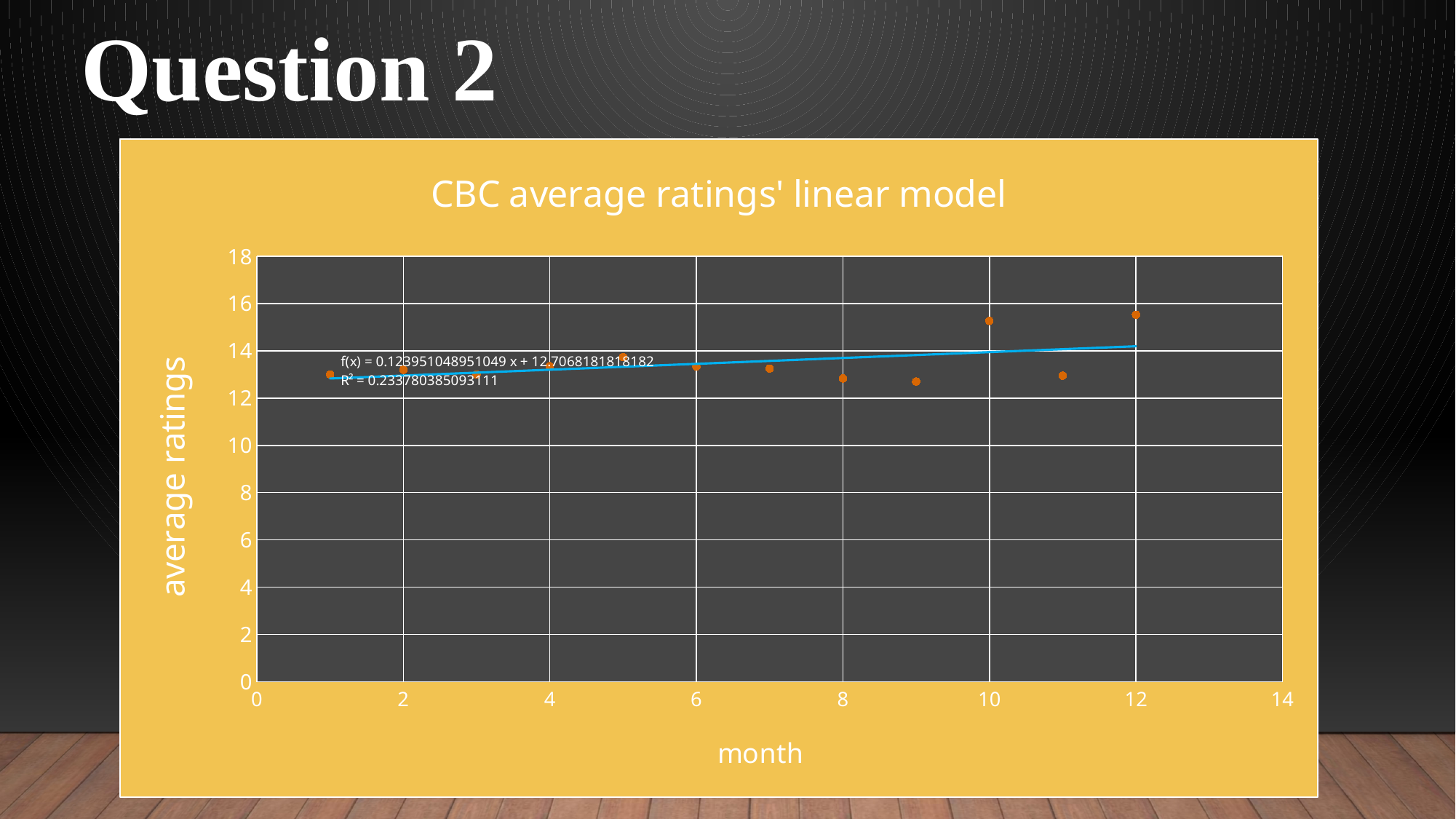
Is the value for month 12 greater or less than 14? greater How many data points are plotted on the chart? 12 What R² value is printed on the chart for the linear model? 0.233780385093111 What is the title of the chart? CBC average ratings' linear model Is the value for month 10 greater or less than 14? greater What is the label of the x axis? month Which is larger, the value for month 10 or the value for month 8? month 10 Is the value for month 1 greater or less than 12? greater Which is larger, the value for month 12 or the value for month 11? month 12 What kind of chart is shown on the slide? scatter chart Does the fitted trendline rise or fall as month increases? rise